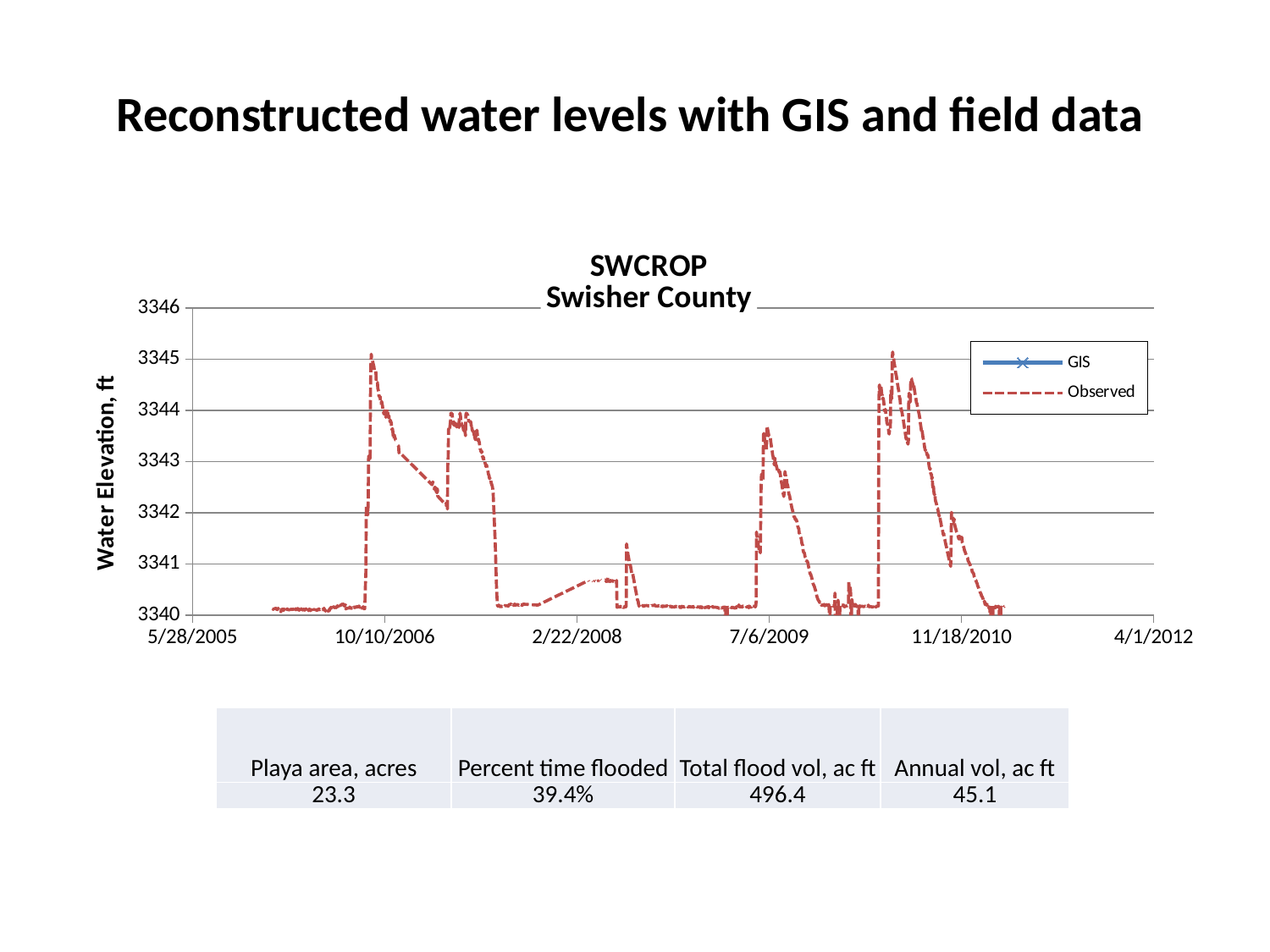
How many series does the chart legend list? 2 Does the Observed line rise or fall from 11/18/2010 to the end of the plotted data? fall Is the peak of the Observed line near 10/10/2006 greater or less than 3344? greater What is the label of the vertical axis of the chart? Water Elevation, ft Is the Observed water elevation at 7/6/2009 greater or less than 3343? greater Is the Observed water elevation at 2/22/2008 greater or less than 3341? less What kind of chart is shown on the slide? line chart What is the title of the chart? SWCROP Swisher County How many date labels are shown on the horizontal axis of the chart? 6